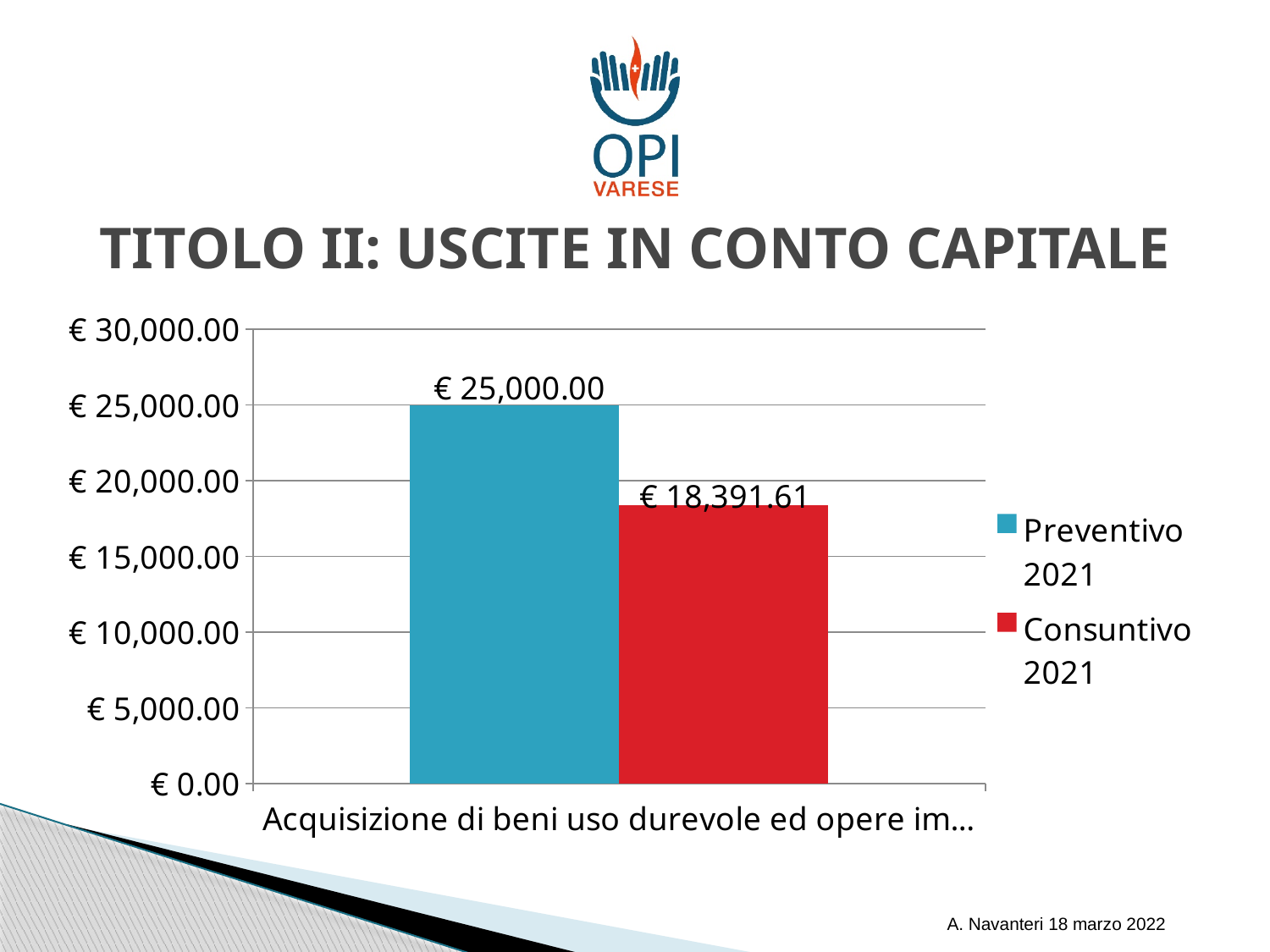
What is the value of the Consuntivo 2021 bar? € 18,391.61 How many categories are shown on the x axis? 1 How many series does the legend list? 2 Which series has the higher value, Preventivo 2021 or Consuntivo 2021? Preventivo 2021 What colour is the Consuntivo 2021 bar? red What kind of chart is shown on the slide? bar chart Which series has the lowest value in the chart? Consuntivo 2021 What is the title of the slide above the chart? TITOLO II: USCITE IN CONTO CAPITALE What is the difference between the Preventivo 2021 and Consuntivo 2021 values? € 6,608.39 Is the value for Preventivo 2021 greater or less than € 20,000.00? greater Is the value for Consuntivo 2021 greater or less than € 20,000.00? less What is the value of the Preventivo 2021 bar? € 25,000.00